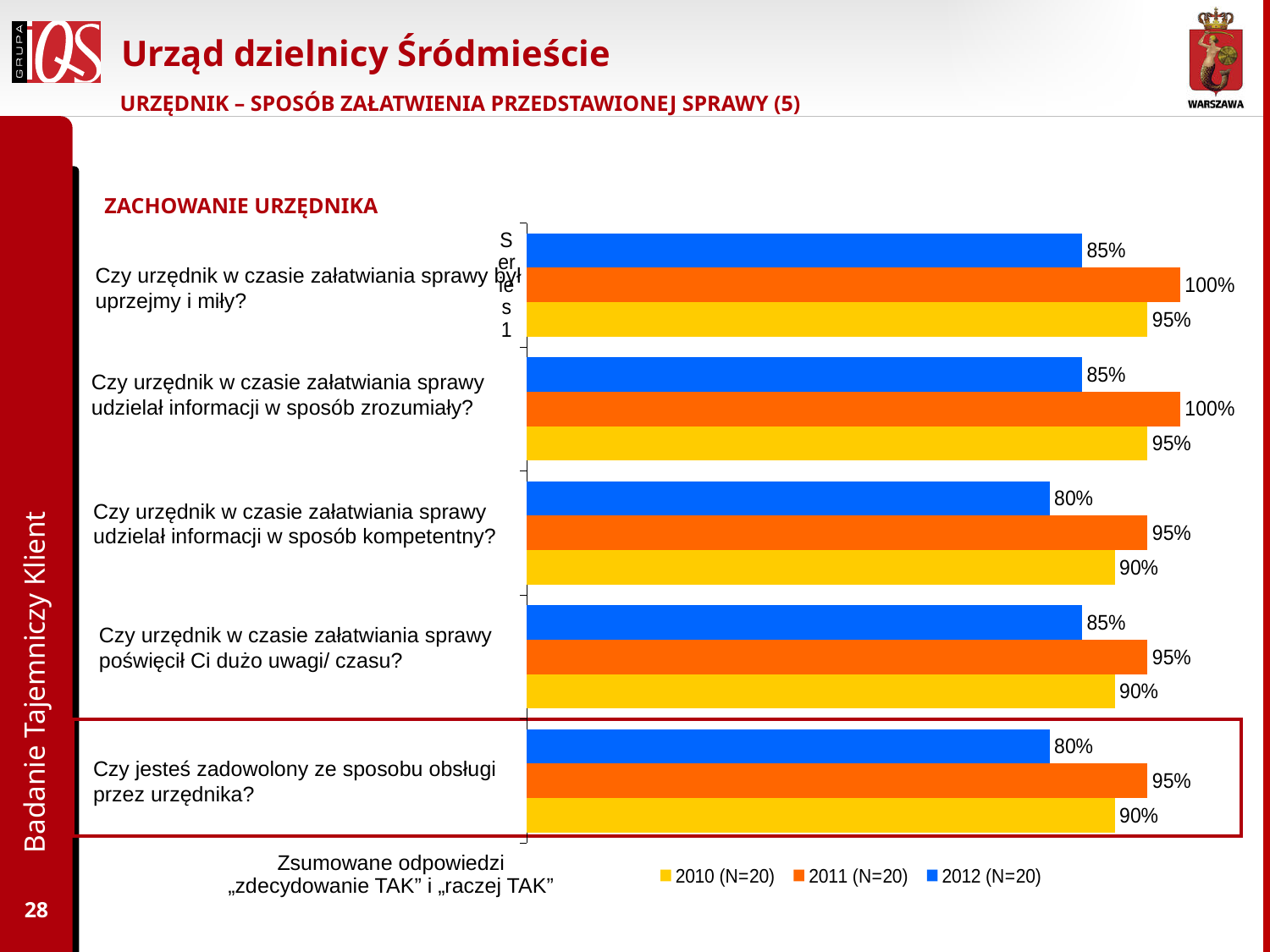
What kind of chart is shown on the slide? bar chart Which year has the highest value for "Czy urzędnik w czasie załatwiania sprawy poświęcił Ci dużo uwagi/ czasu?"? 2011 What is the 2010 (N=20) value for "Czy urzędnik w czasie załatwiania sprawy udzielał informacji w sposób kompetentny?"? 90% What is the difference between the 2011 and 2012 values for "Czy urzędnik w czasie załatwiania sprawy udzielał informacji w sposób zrozumiały?"? 15% For "Czy jesteś zadowolony ze sposobu obsługi przez urzędnika?", which year has the larger value, 2010 or 2012? 2010 What is the 2012 (N=20) value for "Czy jesteś zadowolony ze sposobu obsługi przez urzędnika?"? 80% How many question categories are plotted on the chart? 5 Which colour represents the 2011 (N=20) series in the legend? orange What is the 2012 (N=20) value for "Czy urzędnik w czasie załatwiania sprawy poświęcił Ci dużo uwagi/ czasu?"? 85% Which year has the lowest value for "Czy urzędnik w czasie załatwiania sprawy udzielał informacji w sposób kompetentny?"? 2012 What is the 2011 (N=20) value for "Czy urzędnik w czasie załatwiania sprawy był uprzejmy i miły?"? 100% How many series does the legend list? 3